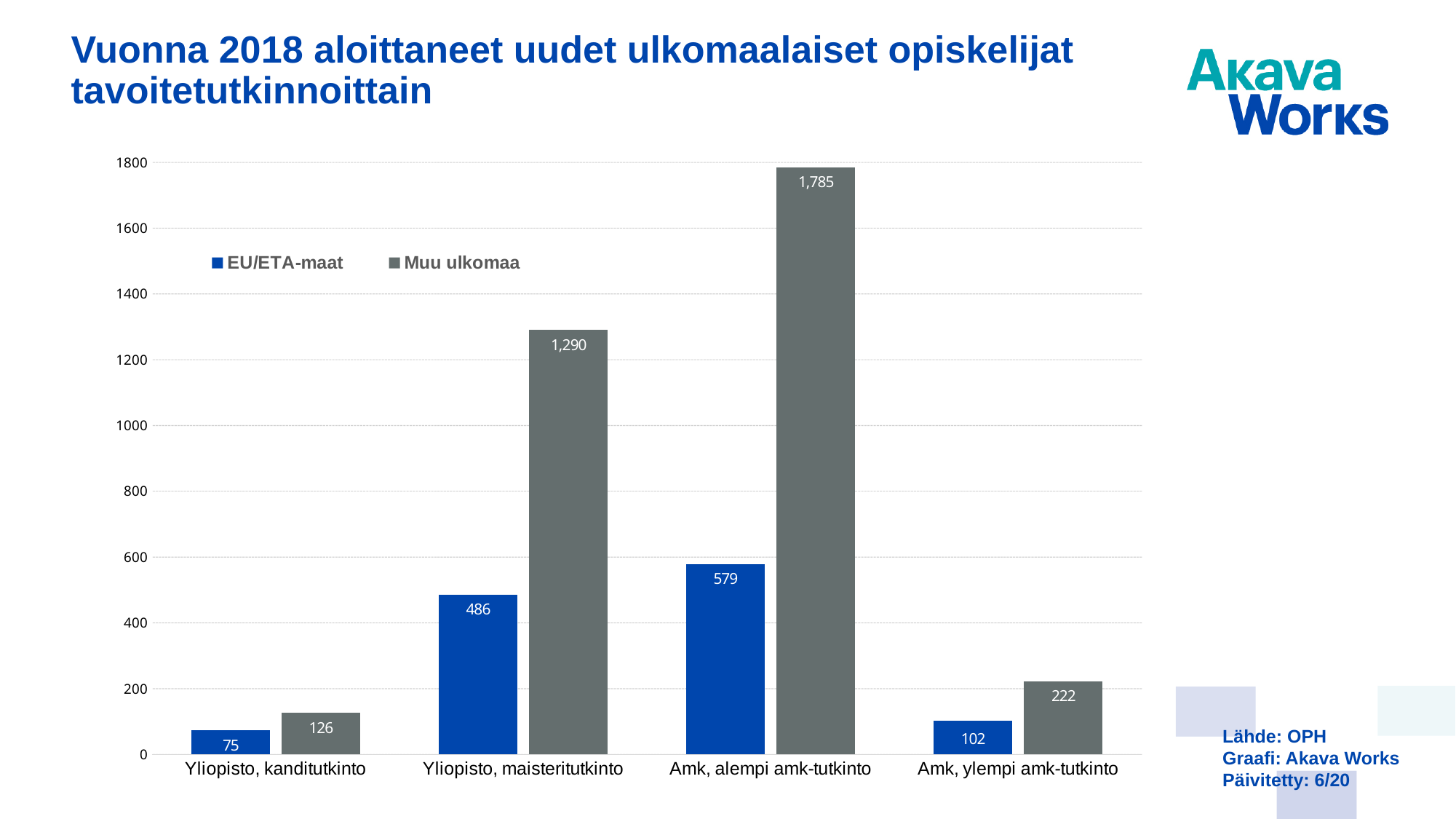
How many series does the legend list? 2 Which category has the highest value for Muu ulkomaa? Amk, alempi amk-tutkinto What is the difference between the Muu ulkomaa and EU/ETA-maat values in the Yliopisto, maisteritutkinto category? 804 Is the value for Muu ulkomaa in the Yliopisto, maisteritutkinto category greater or less than 1200? greater What is the value for EU/ETA-maat in the Yliopisto, maisteritutkinto category? 486 Which category has the lowest value for EU/ETA-maat? Yliopisto, kanditutkinto How many categories are shown on the x axis? 4 What is the source given for the chart data? OPH What is the value for Muu ulkomaa in the Amk, alempi amk-tutkinto category? 1,785 What kind of chart is shown on the slide? Bar chart Which is larger in the Amk, ylempi amk-tutkinto category: EU/ETA-maat or Muu ulkomaa? Muu ulkomaa What is the value for EU/ETA-maat in the Yliopisto, kanditutkinto category? 75